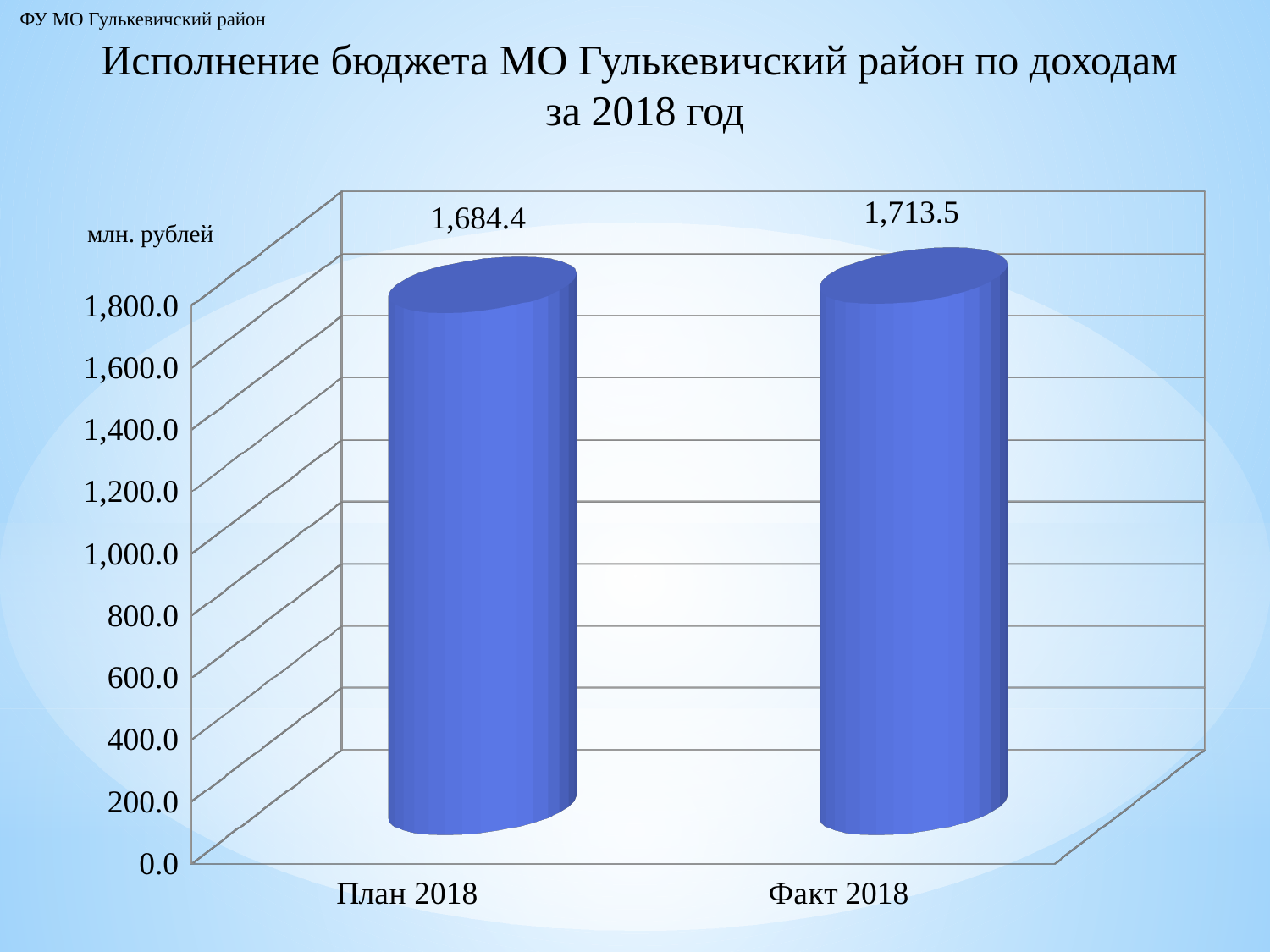
Which category has the highest value? Факт 2018 Is the value for План 2018 greater or less than 1,600.0? greater What unit of measurement is indicated on the chart? млн. рублей Which category has the lowest value? План 2018 What is the difference between the values for Факт 2018 and План 2018? 29.1 Which is larger, the value for План 2018 or the value for Факт 2018? Факт 2018 What is the title of the chart? Исполнение бюджета МО Гулькевичский район по доходам за 2018 год What is the value for Факт 2018? 1,713.5 What is the value for План 2018? 1,684.4 Is the value for Факт 2018 greater or less than 1,800.0? less What kind of chart is shown on the slide? bar chart How many categories are shown on the chart? 2